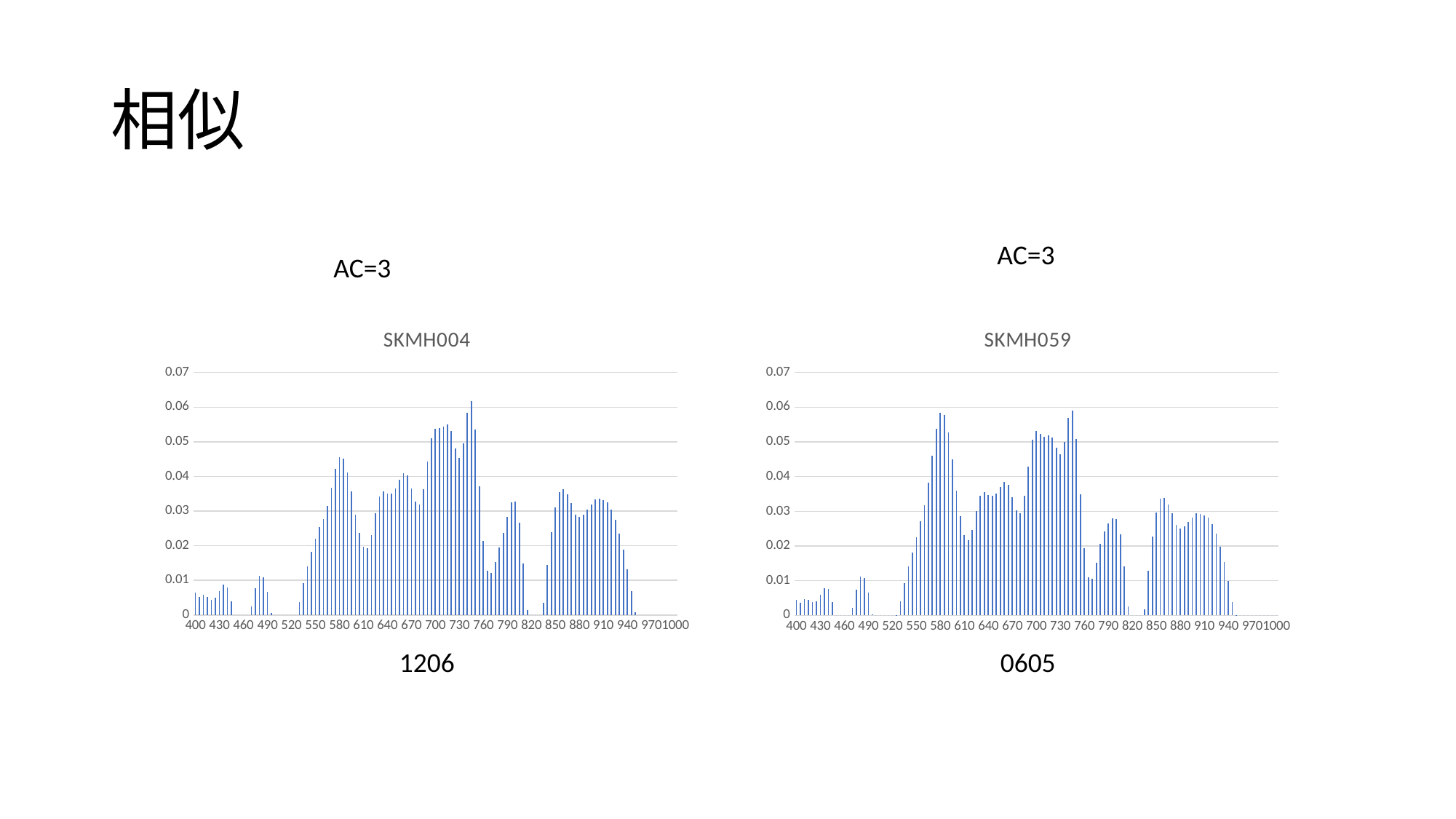
In the SKMH059 chart, are the bars near 430 greater or less than 0.01? less In the SKMH059 chart, are the bars near 970 greater or less than 0.01? less What is the title of the chart on the right? SKMH059 In the SKMH059 chart, is the tallest bar greater or less than 0.05? greater In the SKMH004 chart, what is the last label on the horizontal axis? 1000 What type of chart is the SKMH004 chart on the left? bar chart In the SKMH059 chart, what is the first label on the horizontal axis? 400 In the SKMH004 chart, what is the highest value shown on the vertical axis? 0.07 What is the title of the chart on the left? SKMH004